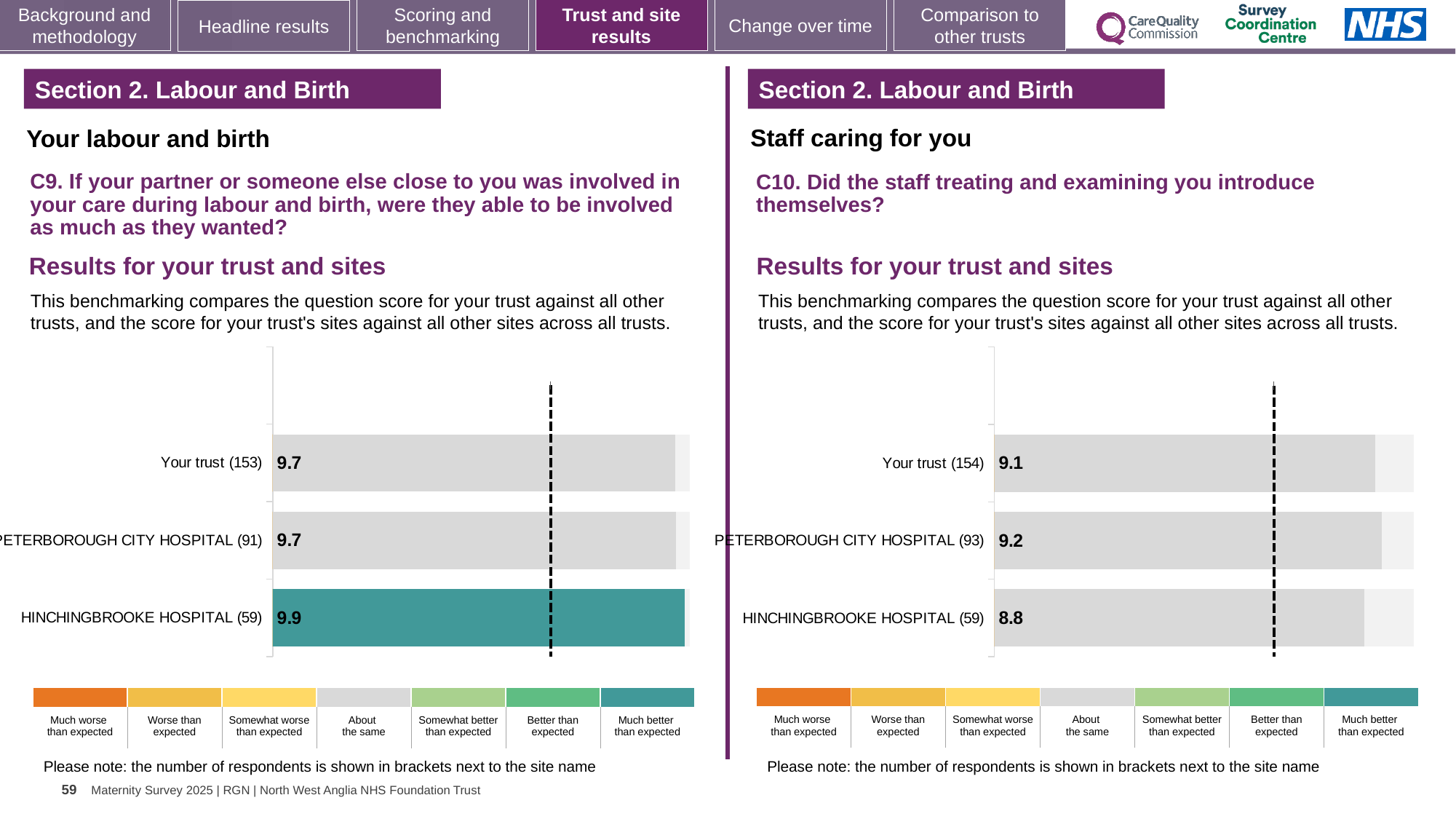
On the right chart (C10), which has the larger score: PETERBOROUGH CITY HOSPITAL (93) or HINCHINGBROOKE HOSPITAL (59)? PETERBOROUGH CITY HOSPITAL (93) On the left chart (C9), what is the difference between the scores for HINCHINGBROOKE HOSPITAL (59) and PETERBOROUGH CITY HOSPITAL (91)? 0.2 On the left chart (C9), which site or trust has the highest score? HINCHINGBROOKE HOSPITAL (59) On the left chart (C9), what is the score for Your trust (153)? 9.7 On the right chart (C10), which site or trust has the lowest score? HINCHINGBROOKE HOSPITAL (59) What type of chart is used on the left (C9) to show the results for your trust and sites? Bar chart On the left chart (C9), how many bars are plotted? 3 On the right chart (C10), what is the score for Your trust (154)? 9.1 On the left chart (C9), what is the score for HINCHINGBROOKE HOSPITAL (59)? 9.9 On the left chart (C9), which bar is coloured teal (Much better than expected)? HINCHINGBROOKE HOSPITAL (59) On the right chart (C10), what is the score for PETERBOROUGH CITY HOSPITAL (93)? 9.2 On the right chart (C10), what is the difference between the scores for PETERBOROUGH CITY HOSPITAL (93) and HINCHINGBROOKE HOSPITAL (59)? 0.4